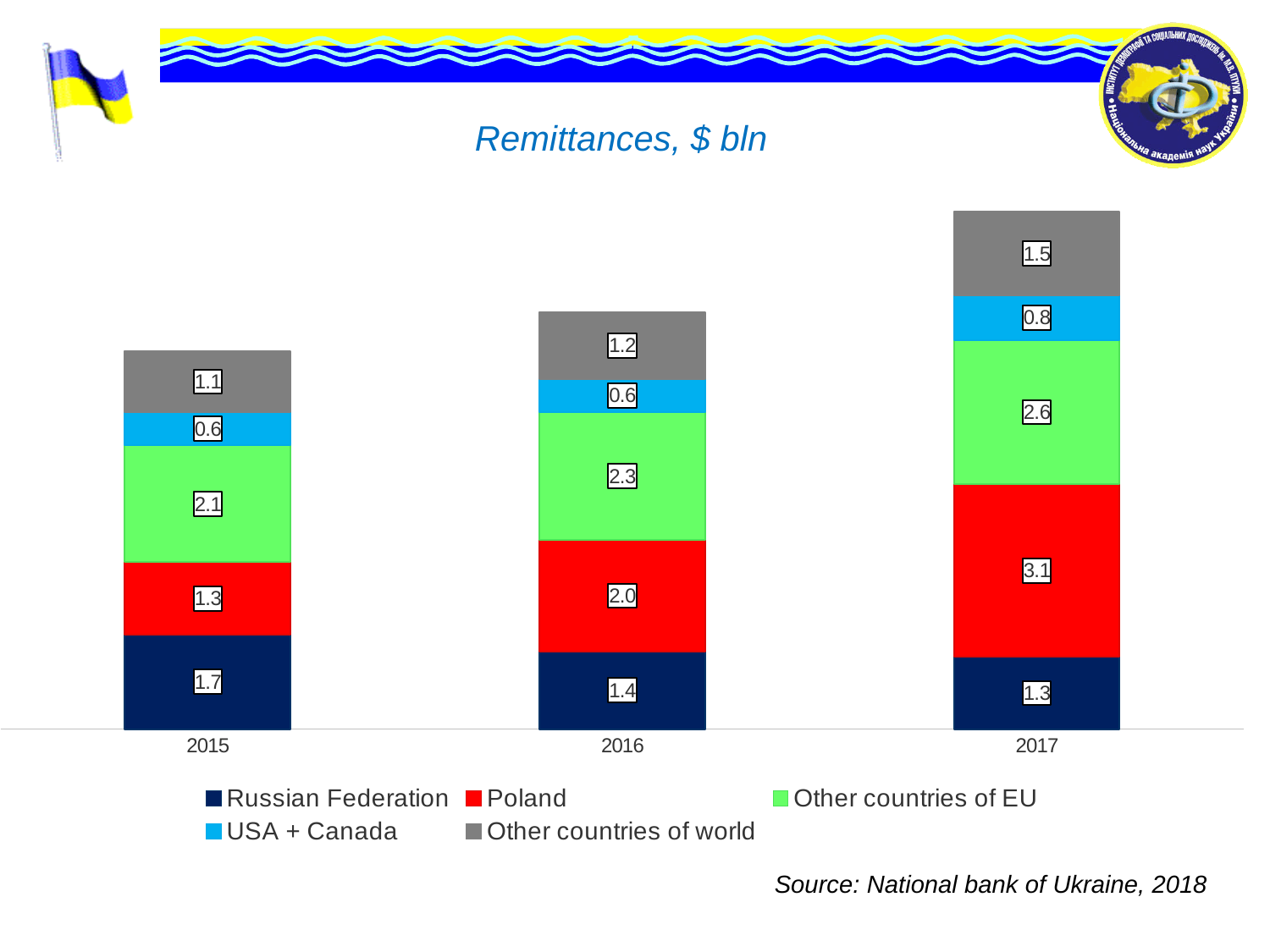
Which is larger in 2016: the value for Poland or the value for Russian Federation? Poland What is the value for Russian Federation in 2015? 1.7 What is the value for USA + Canada in 2017? 0.8 What kind of chart is shown on the slide? Stacked bar chart How many series does the legend list? 5 How many years are shown on the x axis? 3 In which year is the value for Poland highest? 2017 What is the difference between the Poland value in 2017 and the Poland value in 2015? 1.8 What is the value for Poland in 2017? 3.1 What is the total of the stacked bar for 2017? 9.3 In which year is the value for Russian Federation lowest? 2017 What is the value for Other countries of EU in 2016? 2.3